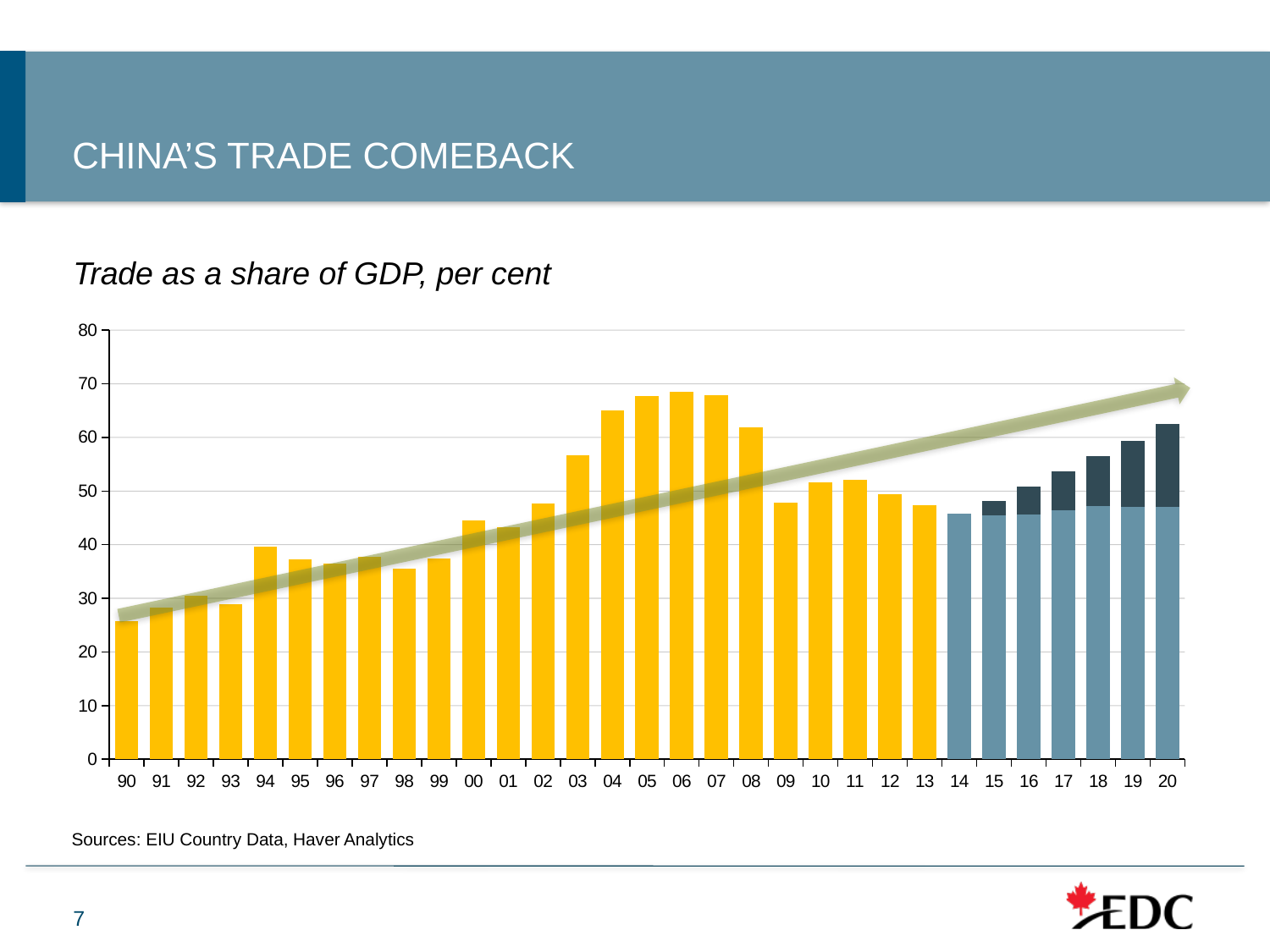
Which is larger, the value for 03 or the value for 11? 03 Is the total value for 20 greater or less than 60? greater Which year has the lowest trade as a share of GDP in the chart? 90 Do the values rise or fall from 90 to 06? rise What kind of chart is shown on the slide? bar chart Which is larger, the value for 04 or the value for 09? 04 Is the value for 06 greater or less than 60? greater Is the value for 13 greater or less than 50? less What is the subtitle describing the chart's measure? Trade as a share of GDP, per cent How many years are shown along the x axis of the chart? 31